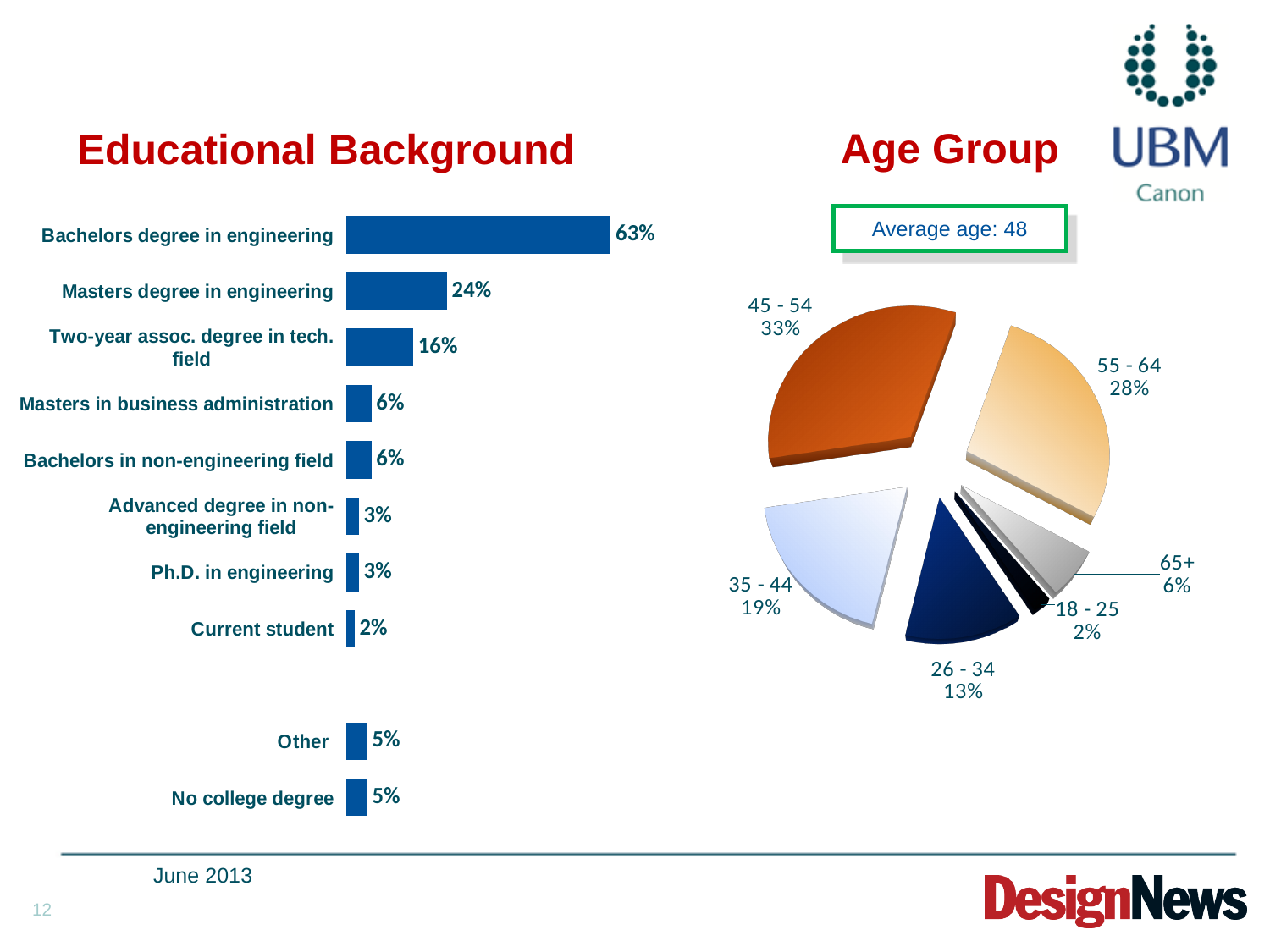
What average age is stated above the Age Group chart? 48 In the Age Group chart, which is larger, 55 - 64 or 35 - 44? 55 - 64 In the Age Group chart, which age group has the smallest slice? 18 - 25 What kind of chart is the Educational Background chart? Bar chart In the Educational Background chart, what is the value for Two-year assoc. degree in tech. field? 16% In the Educational Background chart, how many categories are shown? 10 In the Age Group chart, what is the value for the 26 - 34 group? 13% In the Educational Background chart, which category has the highest value? Bachelors degree in engineering In the Educational Background chart, what percentage have a Bachelors degree in engineering? 63% In the Educational Background chart, what is the difference between Bachelors degree in engineering and Masters degree in engineering? 39% In the Age Group chart, what share of the pie is the 45 - 54 group? 33% In the Educational Background chart, which category has the lowest value? Current student